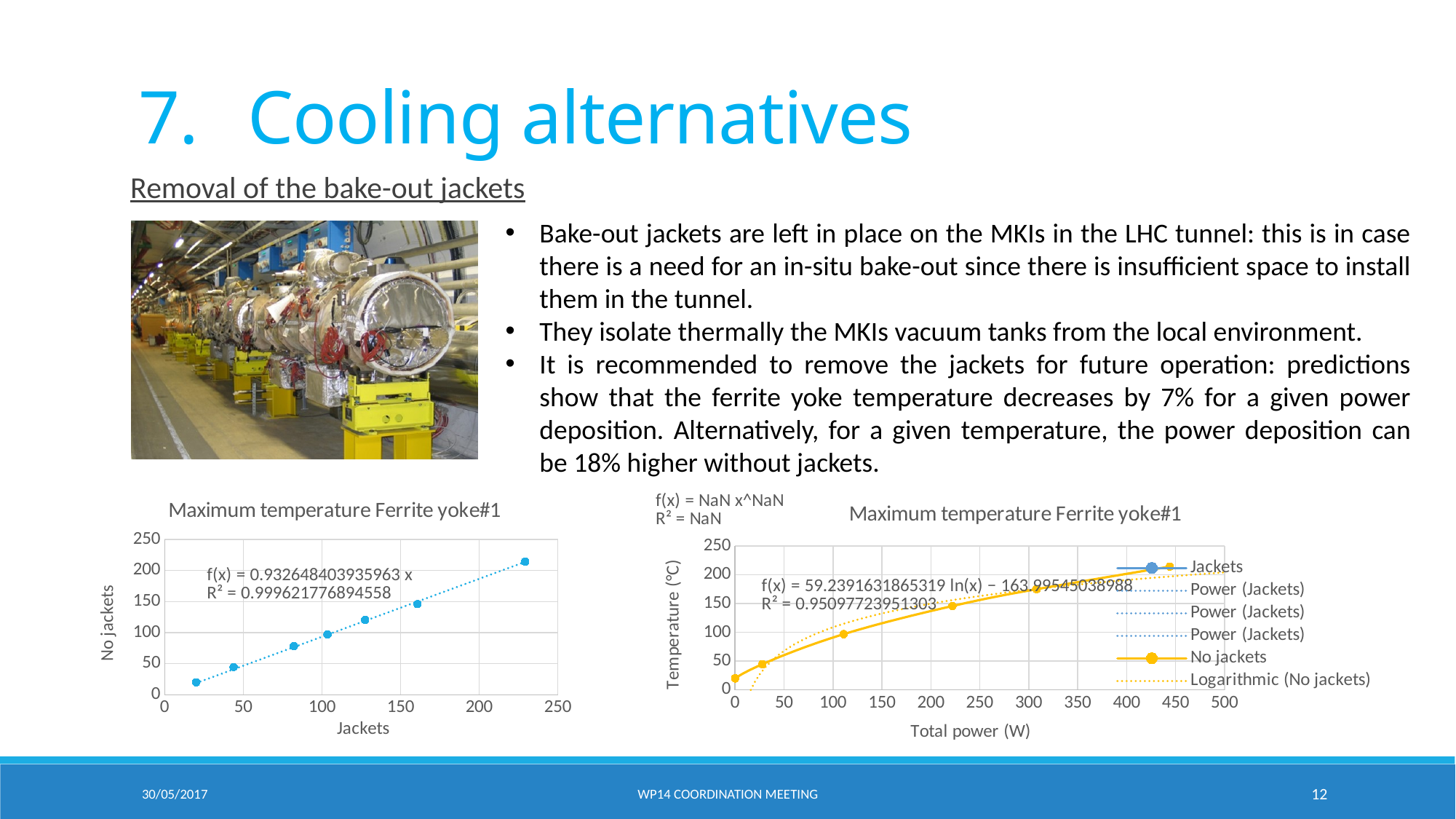
In the right chart, is the 'No jackets' temperature at 0 W greater or less than 50? less In the left chart, what is the R² value shown for the trendline? 0.999621776894558 What type of chart is the left chart titled 'Maximum temperature Ferrite yoke#1'? scatter chart In the left chart, what is the trendline equation shown? f(x) = 0.932648403935963 x In the left chart, do the values rise or fall as the x axis (Jackets) increases? rise In the left chart, is the 'No jackets' value for the leftmost point greater or less than 50? less In the left chart, how many data points are plotted? 7 In the right chart, is the 'No jackets' temperature at about 300 W greater or less than 150? greater In the right chart, how many entries does the legend list? 6 In the right chart, does the 'No jackets' temperature rise or fall as total power increases? rise What is the x-axis title of the right chart? Total power (W)